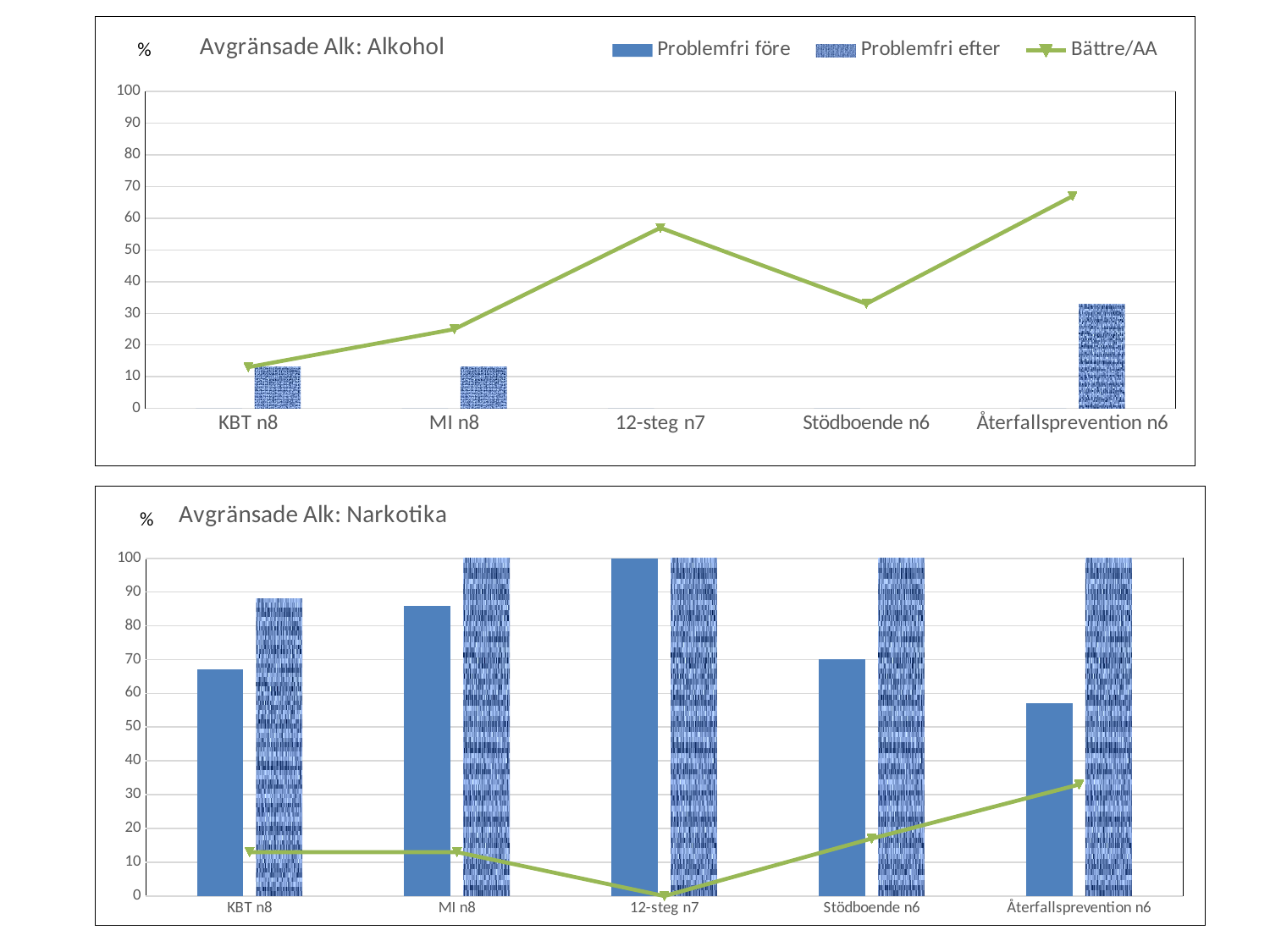
In the 'Avgränsade Alk: Narkotika' chart, what is the Problemfri före value for 12-steg n7? 100 In the 'Avgränsade Alk: Narkotika' chart, which is larger for KBT n8: Problemfri före or Problemfri efter? Problemfri efter In the 'Avgränsade Alk: Narkotika' chart, what is the Bättre/AA value for 12-steg n7? 0 How many categories are shown on the x axis of the 'Avgränsade Alk: Alkohol' chart? 5 How many series does the legend on the slide list? 3 In the 'Avgränsade Alk: Narkotika' chart, which category has the lowest Bättre/AA value? 12-steg n7 In the 'Avgränsade Alk: Narkotika' chart, which category has the lowest Problemfri före value? Återfallsprevention n6 What kind of chart is the 'Avgränsade Alk: Narkotika' chart? Combined bar and line chart In the 'Avgränsade Alk: Alkohol' chart, is the Bättre/AA value for 12-steg n7 greater or less than 50? greater In the 'Avgränsade Alk: Narkotika' chart, what is the Problemfri efter value for MI n8? 100 In the 'Avgränsade Alk: Alkohol' chart, which category has the highest Bättre/AA value? Återfallsprevention n6 In the 'Avgränsade Alk: Narkotika' chart, is the Problemfri före value for KBT n8 greater or less than 60? greater